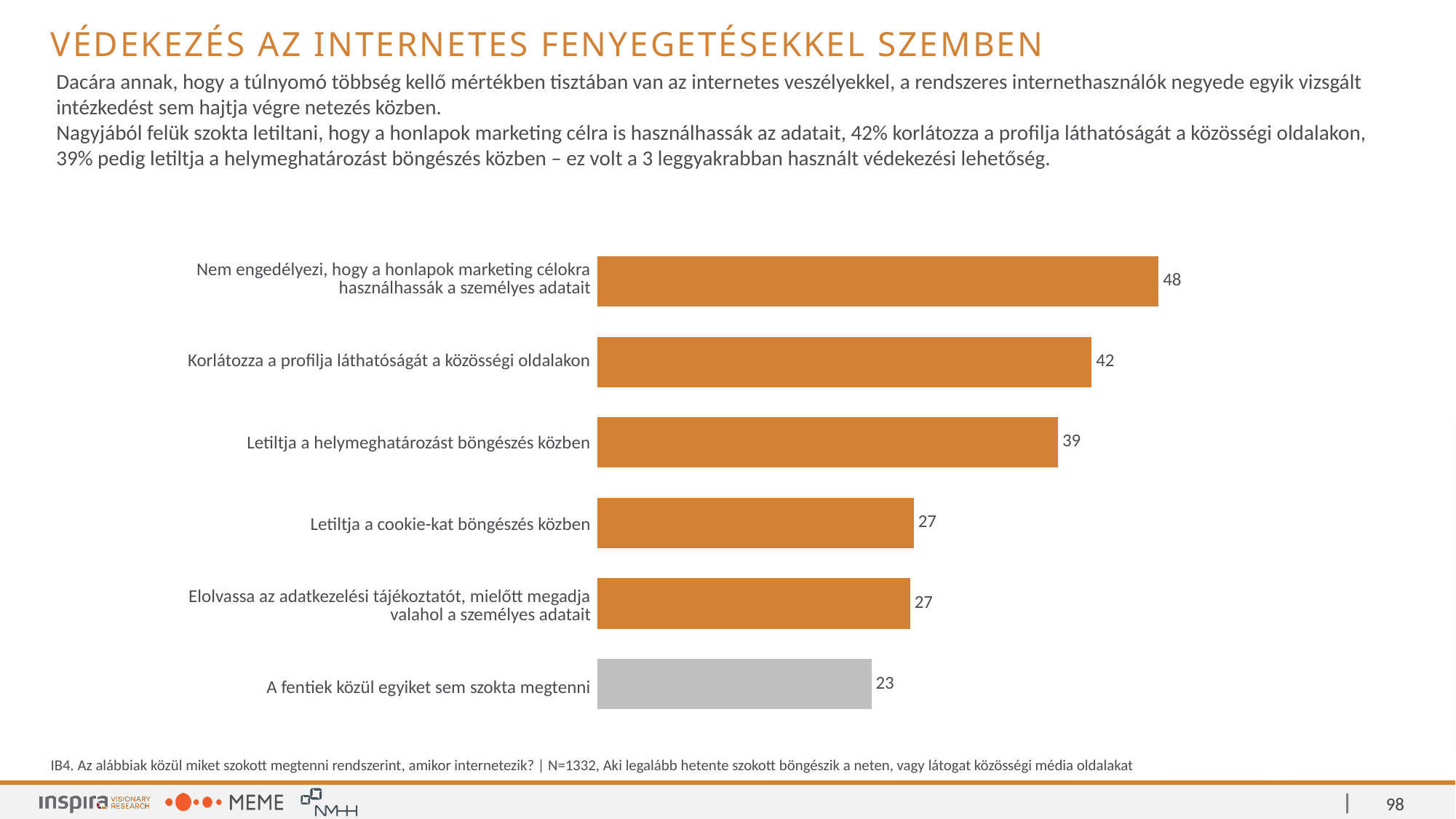
How many categories are shown in the chart? 6 What is the value for "Korlátozza a profilja láthatóságát a közösségi oldalakon"? 42 What is the difference between the value for "Letiltja a helymeghatározást böngészés közben" and the value for "A fentiek közül egyiket sem szokta megtenni"? 16 Which is larger: the value for "Letiltja a helymeghatározást böngészés közben" or the value for "Letiltja a cookie-kat böngészés közben"? Letiltja a helymeghatározást böngészés közben Which category has the highest value? Nem engedélyezi, hogy a honlapok marketing célokra használhassák a személyes adatait Which bar is coloured grey rather than orange? A fentiek közül egyiket sem szokta megtenni What is the value for "Letiltja a cookie-kat böngészés közben"? 27 Which category has the lowest value? A fentiek közül egyiket sem szokta megtenni What kind of chart is shown on the slide? Bar chart What is the value for "A fentiek közül egyiket sem szokta megtenni"? 23 What is the value for "Letiltja a helymeghatározást böngészés közben"? 39 What is the difference between the value for "Nem engedélyezi, hogy a honlapok marketing célokra használhassák a személyes adatait" and the value for "Korlátozza a profilja láthatóságát a közösségi oldalakon"? 6